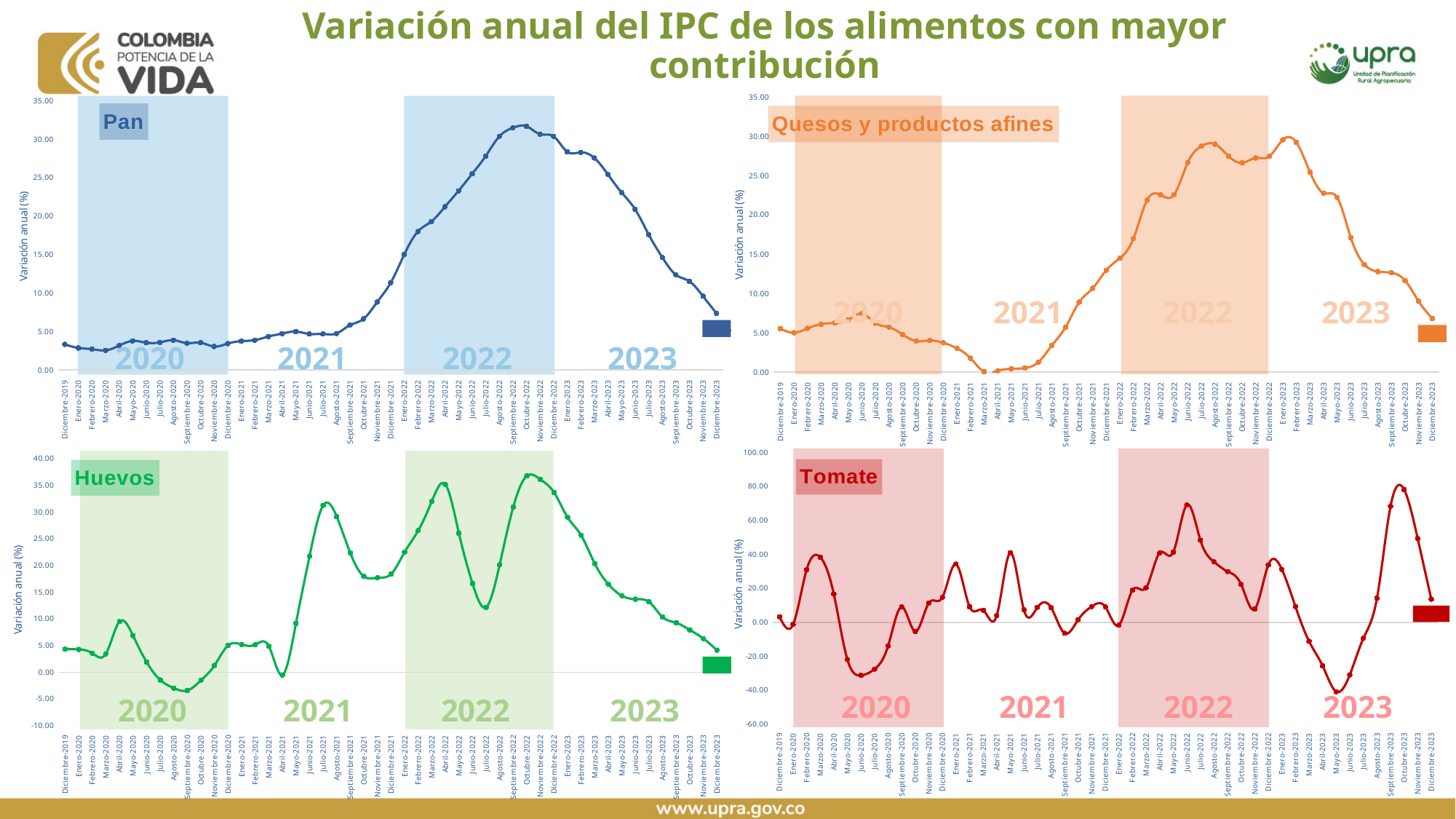
How many charts are shown on the slide? 4 In the Quesos y productos afines chart, do the values rise or fall from Enero-2022 to Agosto-2022? rise In the Tomate chart, is the value for Mayo-2023 greater or less than -20? less In the Quesos y productos afines chart, is the value for Marzo-2021 greater or less than 5? less In the Huevos chart, is the value for Diciembre-2023 greater or less than 5? less In the Tomate chart, which month has the highest value? Octubre-2023 What is the y-axis label on the Huevos chart? Variación anual (%) In the Pan chart, do the values rise or fall from Enero-2023 to Diciembre-2023? fall What kind of chart is used for the Pan panel? line chart